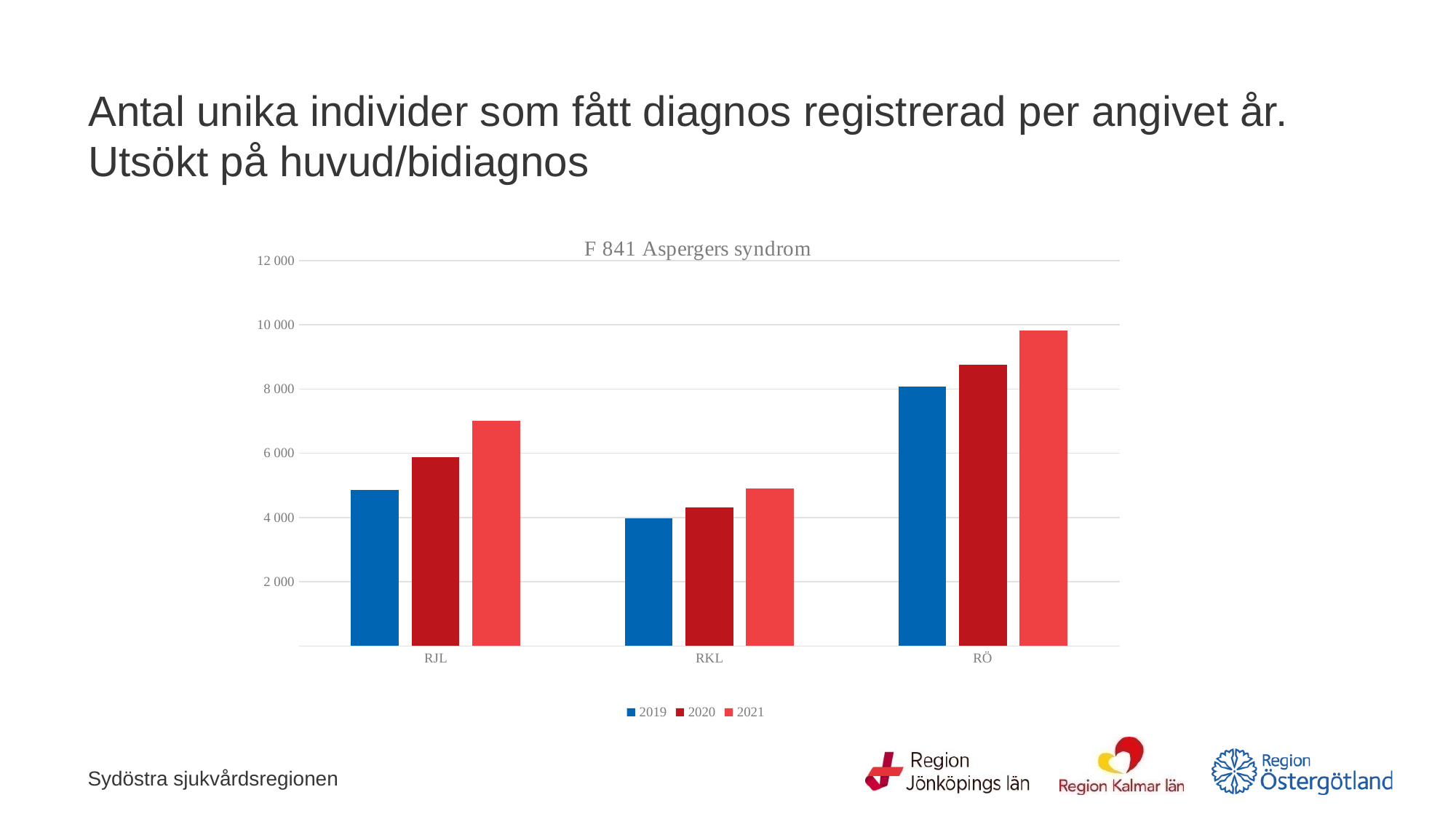
Which category has the highest value for 2021? RÖ What is the title of the chart? F 841 Aspergers syndrom Which category has the lowest value for 2019? RKL Is the value for RÖ in 2021 greater or less than 8 000? greater Which is larger, the 2021 value for RJL or the 2021 value for RKL? RJL What type of chart is shown on the slide? Bar chart How many categories are shown on the x axis? 3 Is the value for RKL in 2019 greater or less than 6 000? less For RÖ, do the values rise or fall from 2019 to 2021? rise Is the value for RÖ in 2020 greater or less than 10 000? less How many series does the legend list? 3